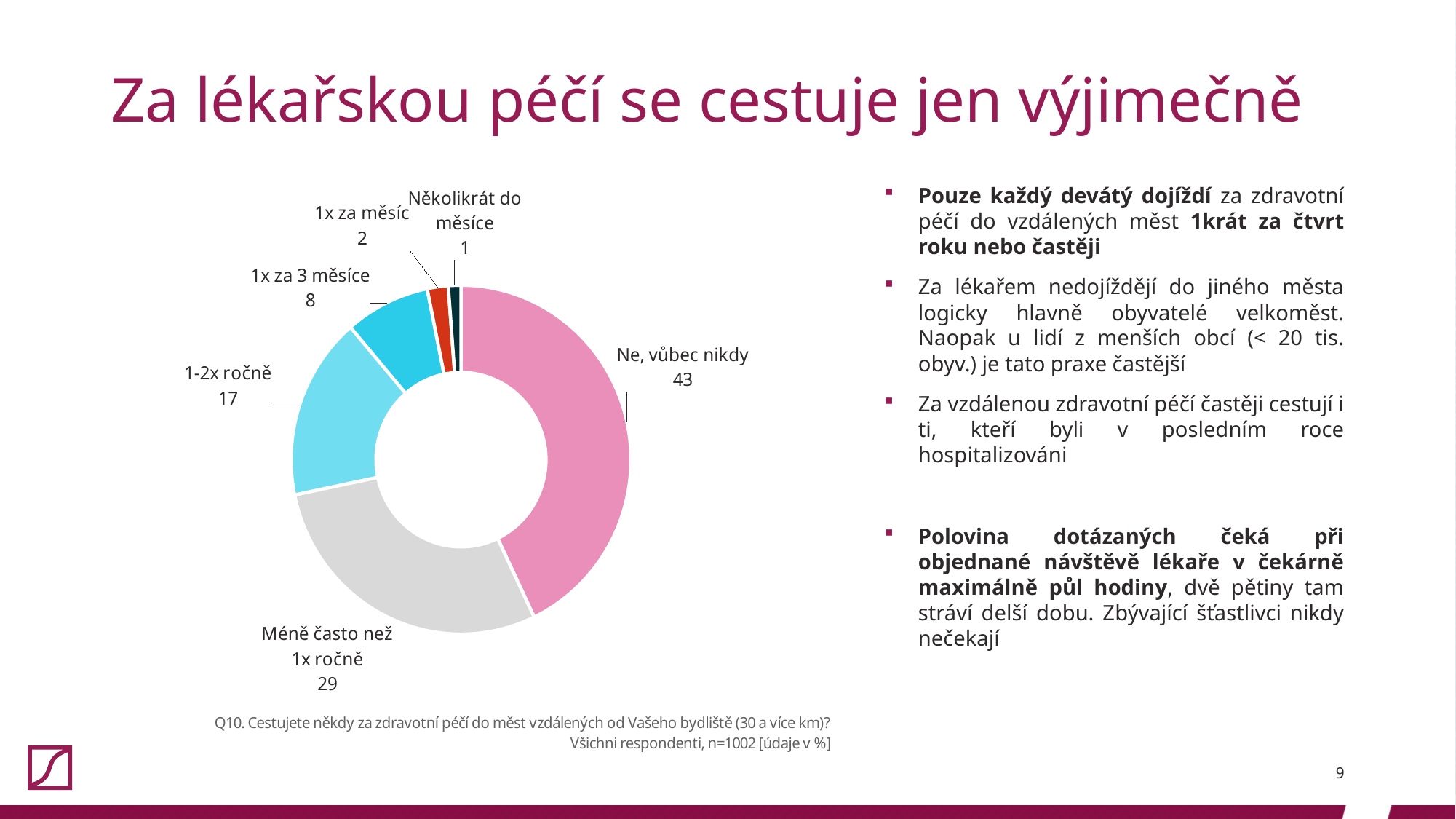
Which category has the largest share of the chart? Ne, vůbec nikdy What kind of chart is shown on the slide? Donut (pie) chart What value is shown for "1-2x ročně"? 17 How many categories are shown in the chart? 6 Which is larger, the value for "1-2x ročně" or the value for "1x za 3 měsíce"? 1-2x ročně Which category has the smallest share of the chart? Několikrát do měsíce What is the difference between the values for "Ne, vůbec nikdy" and "Méně často než 1x ročně"? 14 What is the sample size stated below the chart? n=1002 What value is shown for "Ne, vůbec nikdy"? 43 What value is shown for "Několikrát do měsíce"? 1 What value is shown for "1x za 3 měsíce"? 8 What value is shown for "Méně často než 1x ročně"? 29